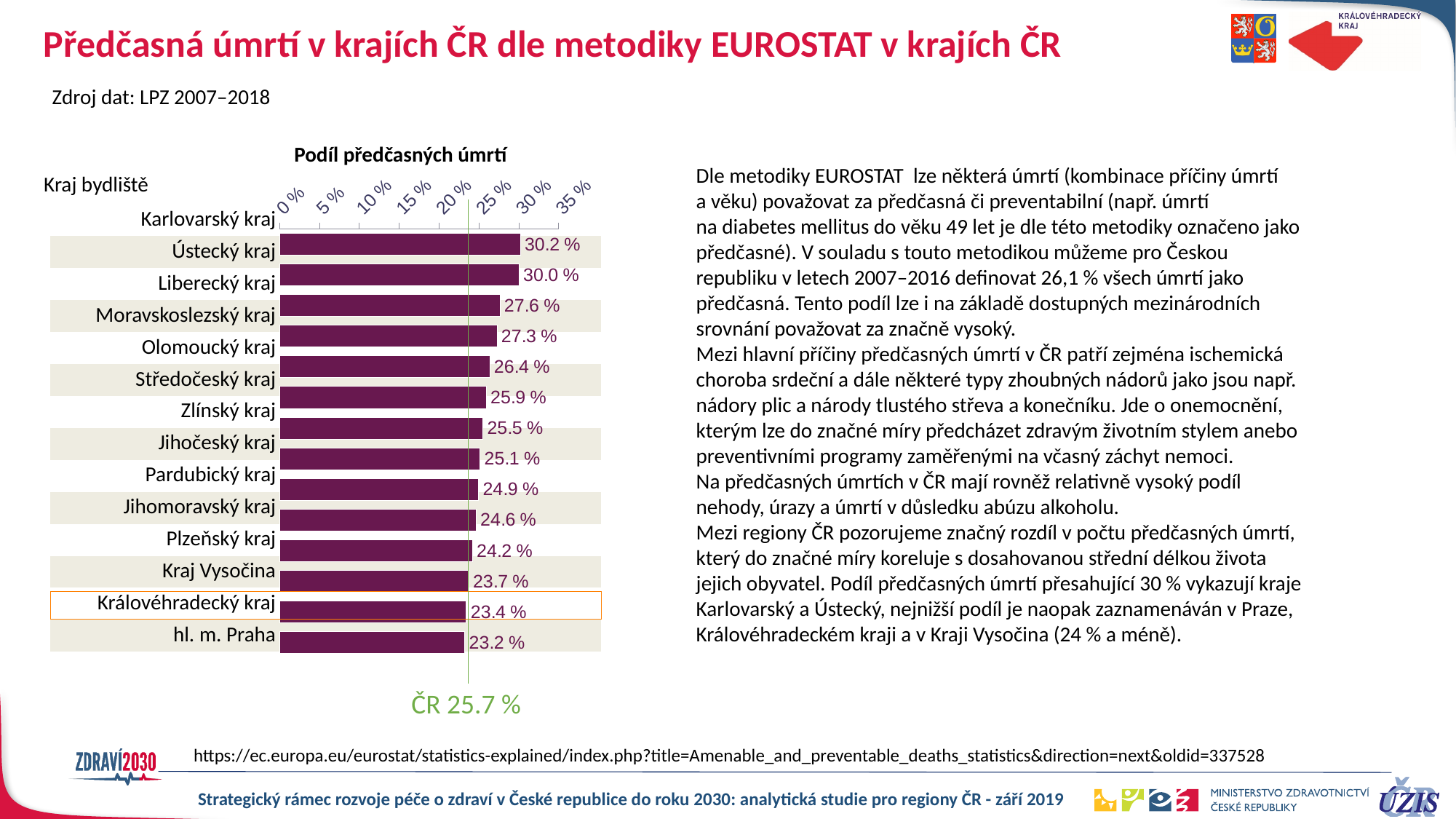
Which region has the highest share of premature deaths? Karlovarský kraj What is the value for Královéhradecký kraj? 23.4 % What is the value shown for ČR (the national average) in the chart? 25.7 % What is the difference between the values for Kraj Vysočina and Královéhradecký kraj? 0.3 % What is the value for Karlovarský kraj? 30.2 % What is the difference between the values for Karlovarský kraj and hl. m. Praha? 7.0 % How many regions are shown in the chart? 14 What is the value for Moravskoslezský kraj? 27.3 % What is the title of the chart? Podíl předčasných úmrtí Which has a higher value, Liberecký kraj or Olomoucký kraj? Liberecký kraj What type of chart is shown on the slide? bar chart Which region has the lowest share of premature deaths? hl. m. Praha